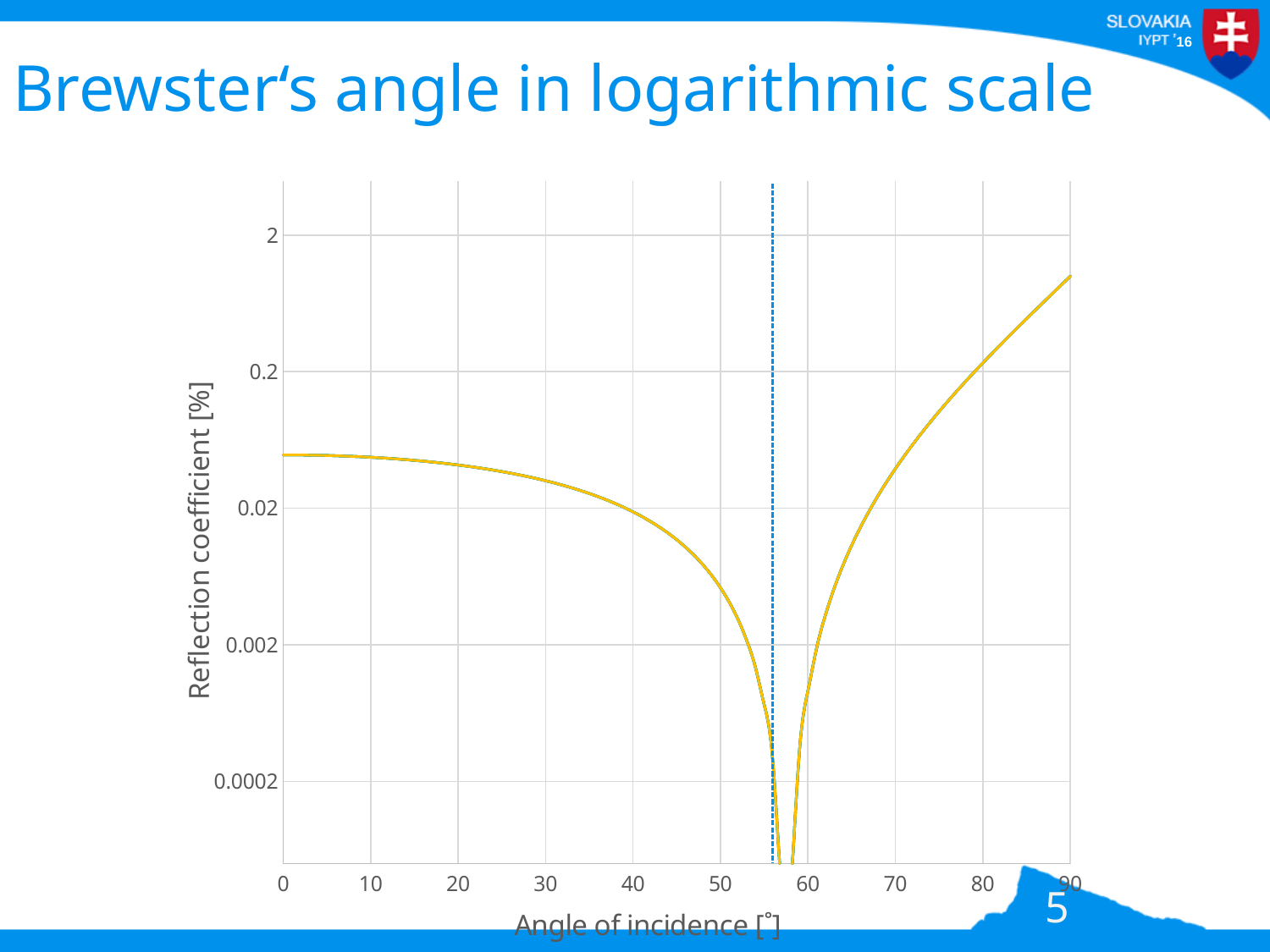
Is the reflection coefficient at an angle of incidence of 90° greater or less than 0.2? greater Is the reflection coefficient at an angle of incidence of 50° greater or less than 0.02? less Is the reflection coefficient at an angle of incidence of 0° greater or less than 0.2? less What kind of chart is shown on the slide? line chart Does the reflection coefficient rise or fall as the angle of incidence increases from 60° to 90°? rise What is the label of the x axis? Angle of incidence [°] What is the title of the chart? Brewster's angle in logarithmic scale Does the reflection coefficient rise or fall as the angle of incidence increases from 0° to 50°? fall Between which two labelled x-axis ticks does the curve reach its minimum? 50 and 60